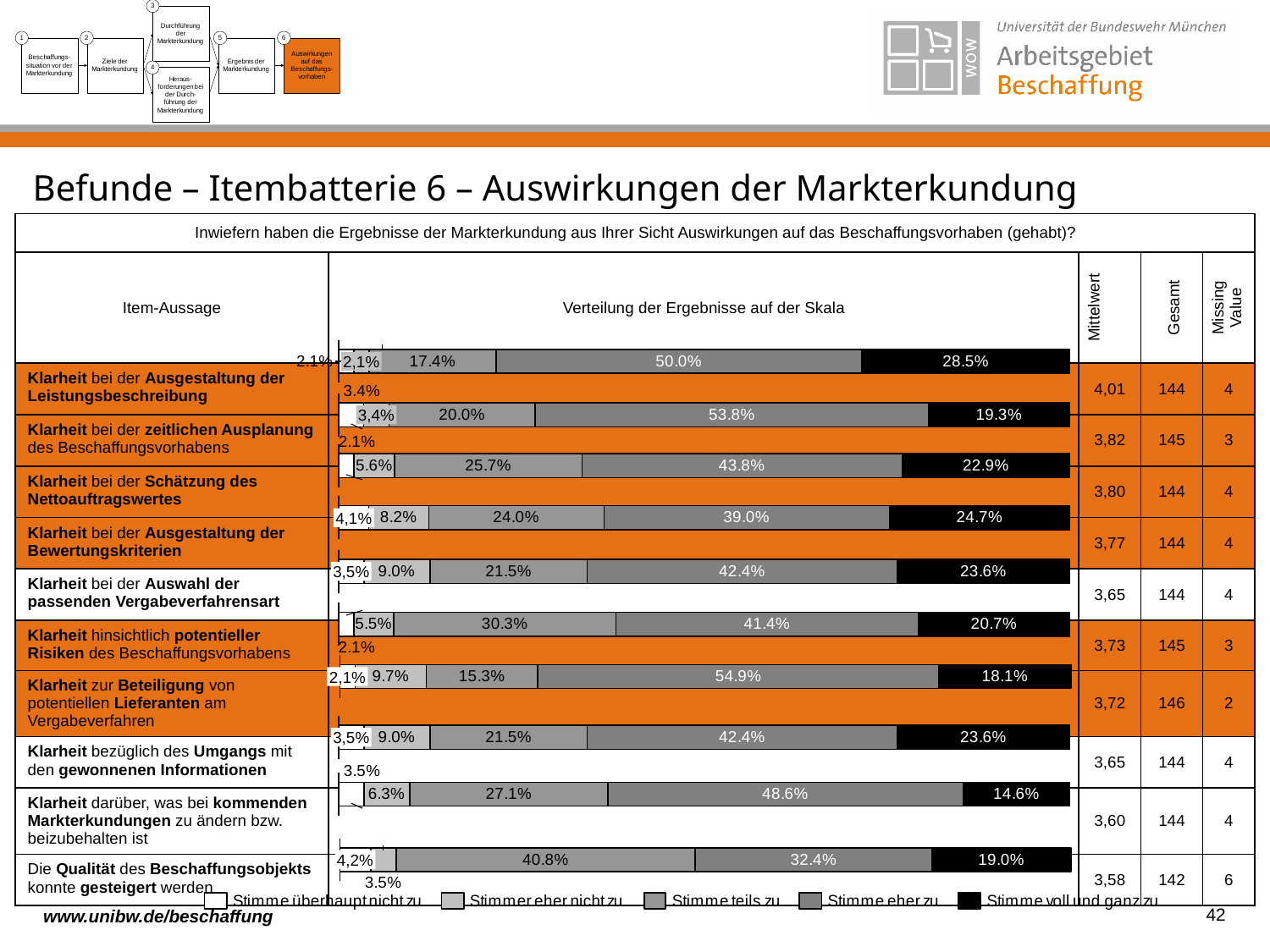
Which bar has the smallest 'Stimme voll und ganz zu' segment? Klarheit darüber, was bei kommenden Markterkundungen zu ändern bzw. beizubehalten ist (14.6%) What is the first entry in the chart's legend? Stimme überhaupt nicht zu What kind of chart is used to show the distribution of responses on the slide? bar chart In the topmost bar (Klarheit bei der Ausgestaltung der Leistungsbeschreibung), what is the value of the 'Stimme eher zu' segment? 50.0% What colour represents 'Stimme voll und ganz zu' in the chart? black Which is larger: the 'Stimme voll und ganz zu' segment of the topmost bar or that of the bottom bar? the topmost bar (28.5% vs 19.0%) How many stacked bars (item statements) are plotted in the chart? 10 How many series does the legend of the chart list? 5 In the bottom bar (Die Qualität des Beschaffungsobjekts konnte gesteigert werden), what is the value of the 'Stimme eher zu' segment? 32.4% In the bottom bar (Die Qualität des Beschaffungsobjekts konnte gesteigert werden), what is the value of the 'Stimme teils zu' segment? 40.8% Which bar has the largest 'Stimme eher zu' segment? Klarheit zur Beteiligung von potentiellen Lieferanten am Vergabeverfahren (54.9%) In the topmost bar, what is the difference between the 'Stimme eher zu' segment (50.0%) and the 'Stimme voll und ganz zu' segment (28.5%)? 21.5%